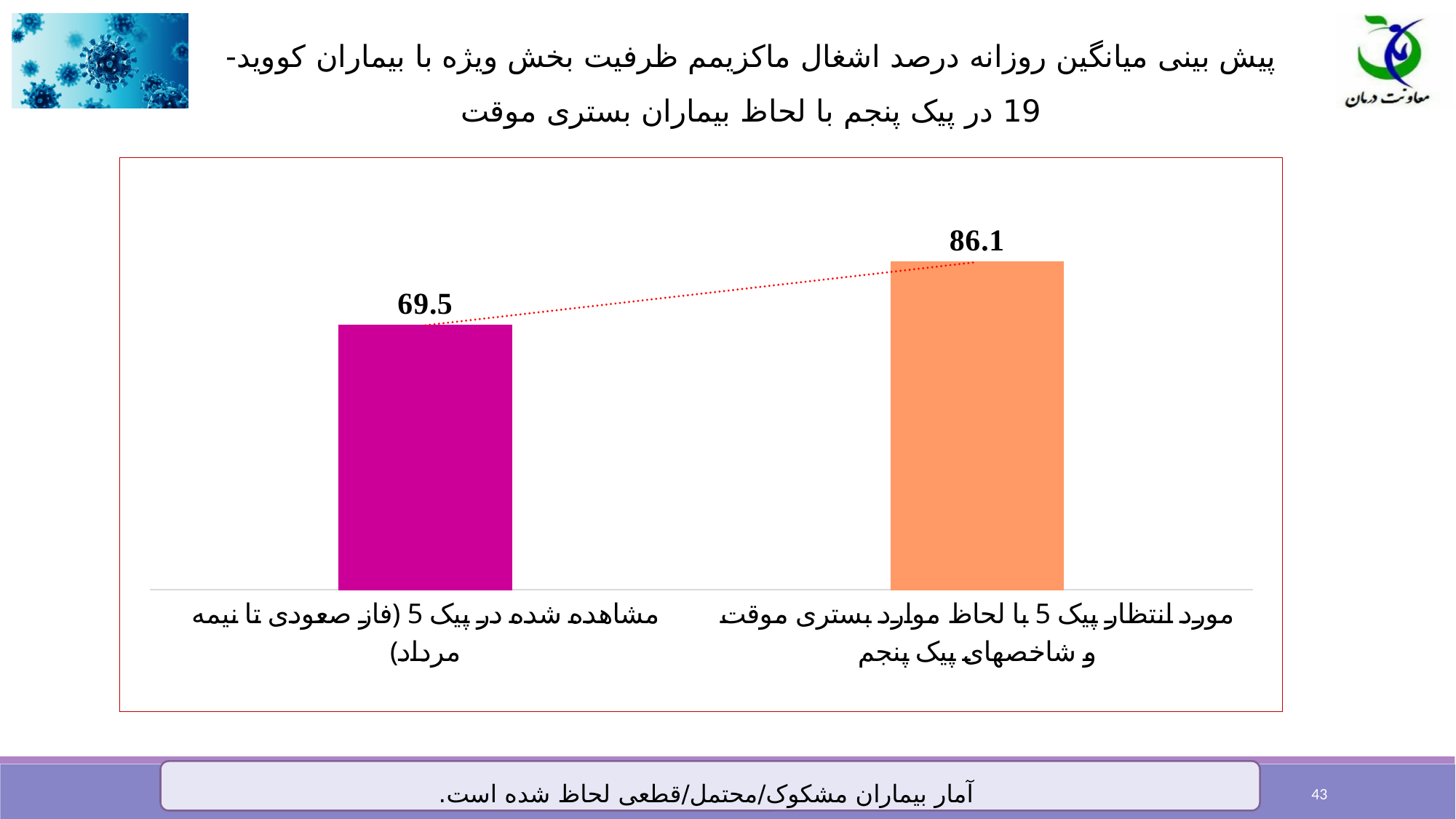
What is the value for the bar labelled "مشاهده شده در پیک 5 (فاز صعودی تا نیمه مرداد)"? 69.5 What colour is the bar for "مورد انتظار پیک 5 با لحاظ موارد بستری موقت و شاخصهای پیک پنجم"? Orange Which is larger: the observed value for peak 5 or the expected value for peak 5? The expected value for peak 5 (86.1) What is the difference between the expected value (86.1) and the observed value (69.5)? 16.6 Which category has the highest value? مورد انتظار پیک 5 با لحاظ موارد بستری موقت و شاخصهای پیک پنجم What is the value for the bar labelled "مورد انتظار پیک 5 با لحاظ موارد بستری موقت و شاخصهای پیک پنجم"? 86.1 What colour is the bar for "مشاهده شده در پیک 5 (فاز صعودی تا نیمه مرداد)"? Magenta (pink-purple) Which category has the lowest value? مشاهده شده در پیک 5 (فاز صعودی تا نیمه مرداد) What kind of chart is shown on the slide? Bar chart How many bars are plotted in the chart? 2